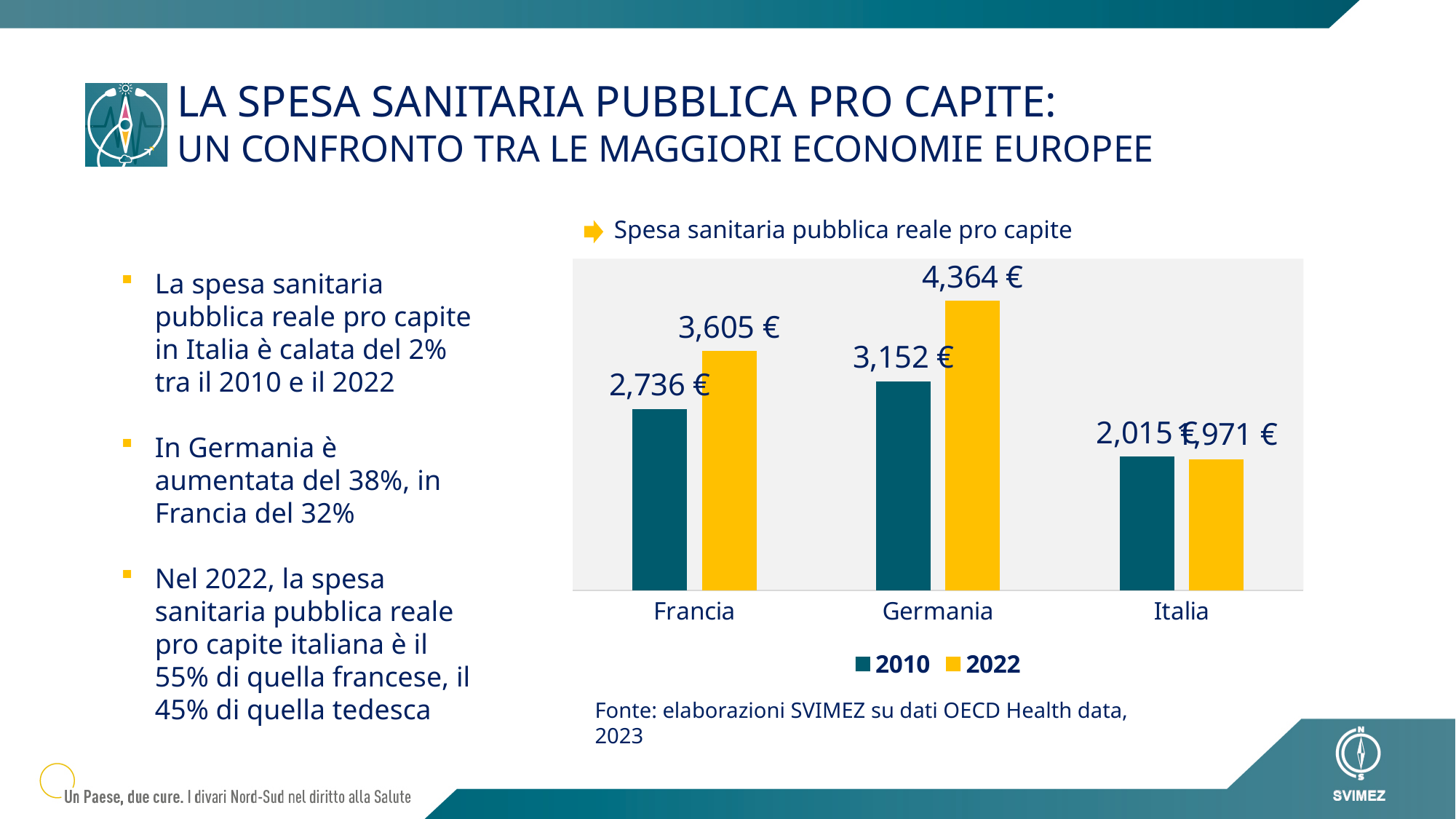
Which is larger: the 2022 value for Francia or the 2010 value for Germania? Francia 2022 What is the difference between the 2022 and 2010 values for Germania? 1,212 € What is the value for Germania in 2010? 3,152 € What type of chart is shown on the slide? Bar chart What is the value for Germania in 2022? 4,364 € What is the difference between the 2022 values for Germania and Francia? 759 € How many countries are shown on the x axis? 3 How many series does the legend list? 2 Which country has the highest value in 2022? Germania Which country has the lowest value in 2010? Italia What is the value for Francia in 2010? 2,736 € What is the value for Italia in 2022? 1,971 €